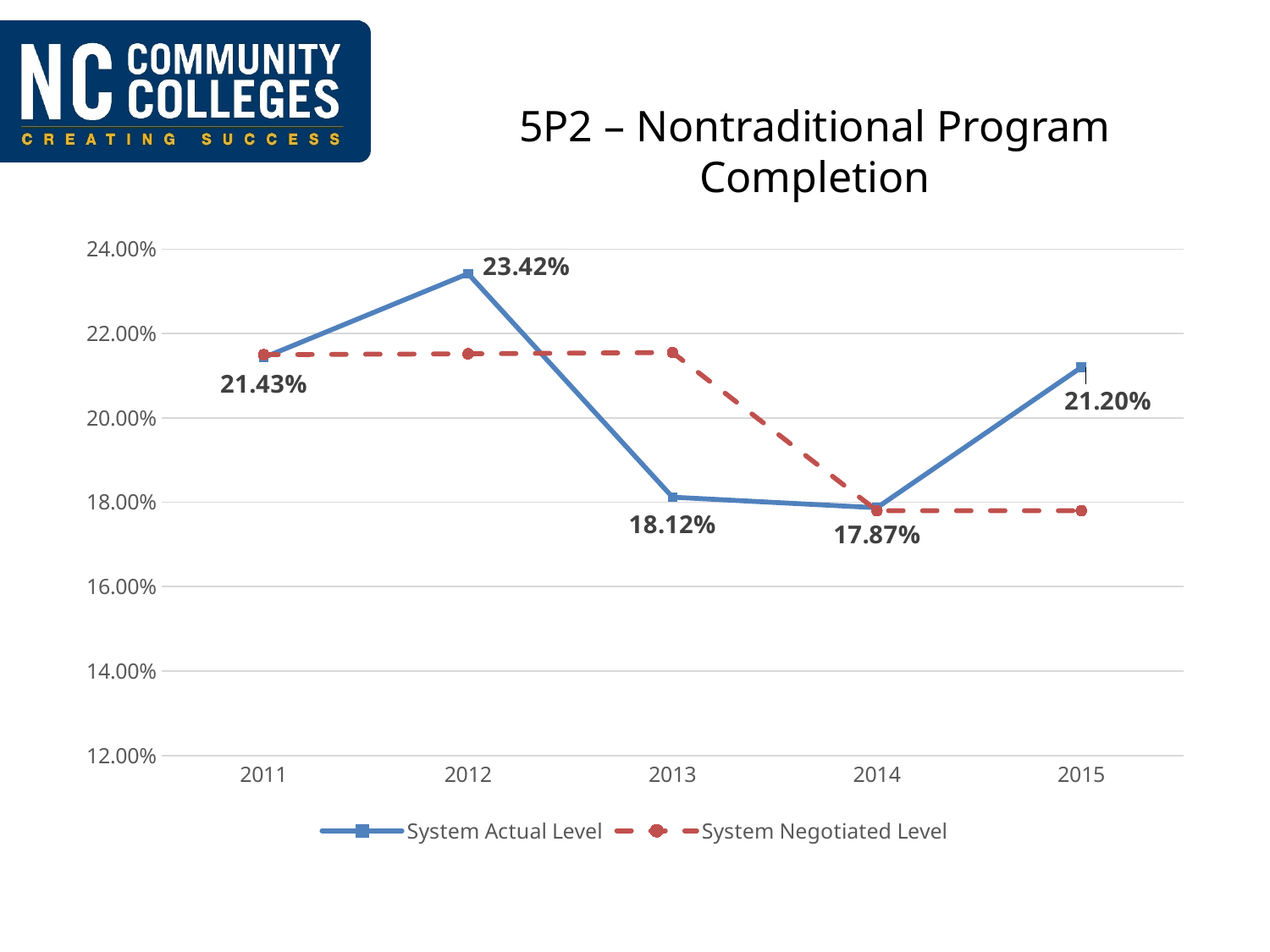
In which year is the System Actual Level lowest? 2014 Is the System Negotiated Level for 2015 greater or less than 18.00%? less Is the System Negotiated Level for 2013 greater or less than 20.00%? greater What is the System Actual Level for 2015? 21.20% Which is larger, the System Actual Level in 2011 or in 2015? 2011 What is the difference between the System Actual Level in 2012 and in 2013? 5.30% What is the System Actual Level for 2012? 23.42% How many years are shown on the x axis? 5 How many series does the legend list? 2 In which year is the System Actual Level highest? 2012 What is the System Actual Level for 2014? 17.87% What kind of chart is shown on the slide? Line chart